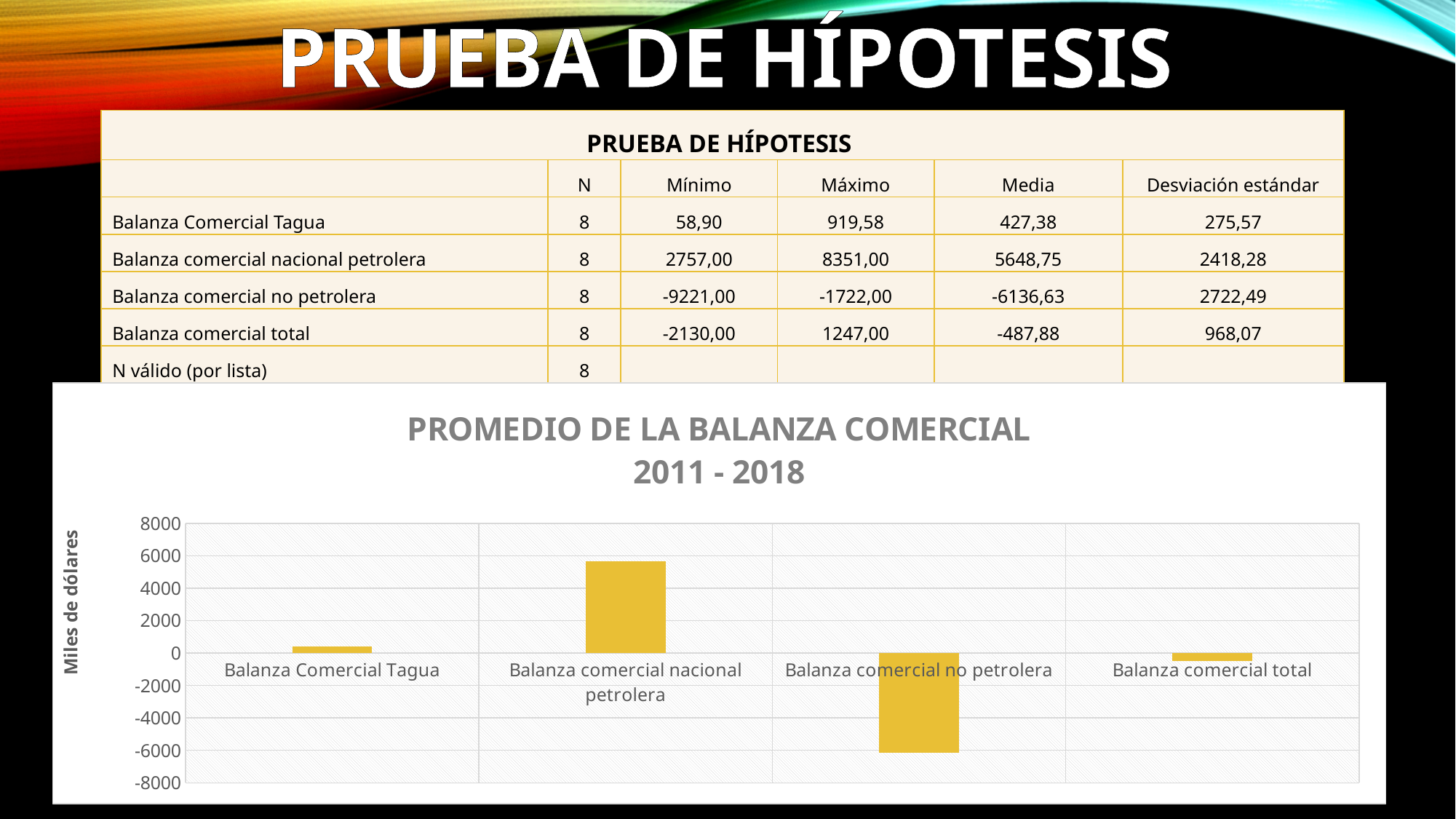
Which category has the highest bar in the chart? Balanza comercial nacional petrolera Is the value for Balanza comercial nacional petrolera greater or less than 4000? greater Is the value for Balanza comercial no petrolera greater or less than -4000? less Which category has the lowest bar in the chart? Balanza comercial no petrolera What kind of chart is shown on the slide? bar chart Which is larger, the value for Balanza comercial nacional petrolera or the value for Balanza comercial no petrolera? Balanza comercial nacional petrolera How many bars in the chart have negative values? 2 Is the value for Balanza Comercial Tagua greater or less than 2000? less How many categories are plotted in the chart? 4 What is the label on the vertical axis of the chart? Miles de dólares What is the title of the chart? PROMEDIO DE LA BALANZA COMERCIAL 2011 - 2018 Which is larger, the value for Balanza Comercial Tagua or the value for Balanza comercial total? Balanza Comercial Tagua